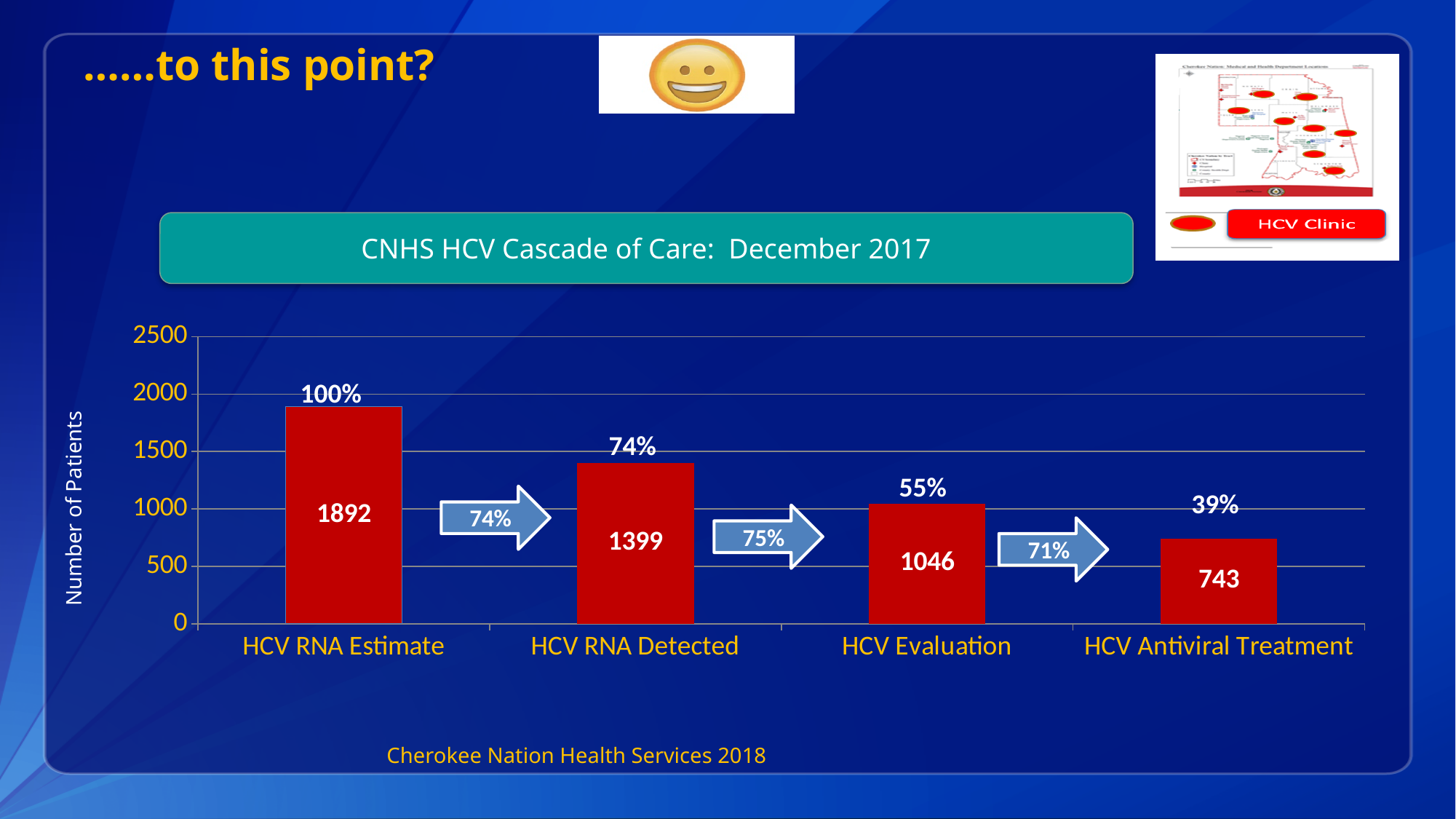
How many categories are shown on the x axis? 4 What is the number of patients for HCV RNA Detected? 1399 What percentage is shown above the HCV Evaluation bar? 55% What is the title of the chart? CNHS HCV Cascade of Care: December 2017 Which category has the highest number of patients? HCV RNA Estimate Do the values rise or fall from left to right along the x axis? fall Is the value for HCV RNA Estimate greater or less than 1500? greater What is the number of patients for HCV Antiviral Treatment? 743 Which category has the lowest number of patients? HCV Antiviral Treatment What kind of chart is shown on the slide? bar chart What is the difference in number of patients between HCV RNA Estimate and HCV RNA Detected? 493 Which has more patients, HCV Evaluation or HCV Antiviral Treatment? HCV Evaluation